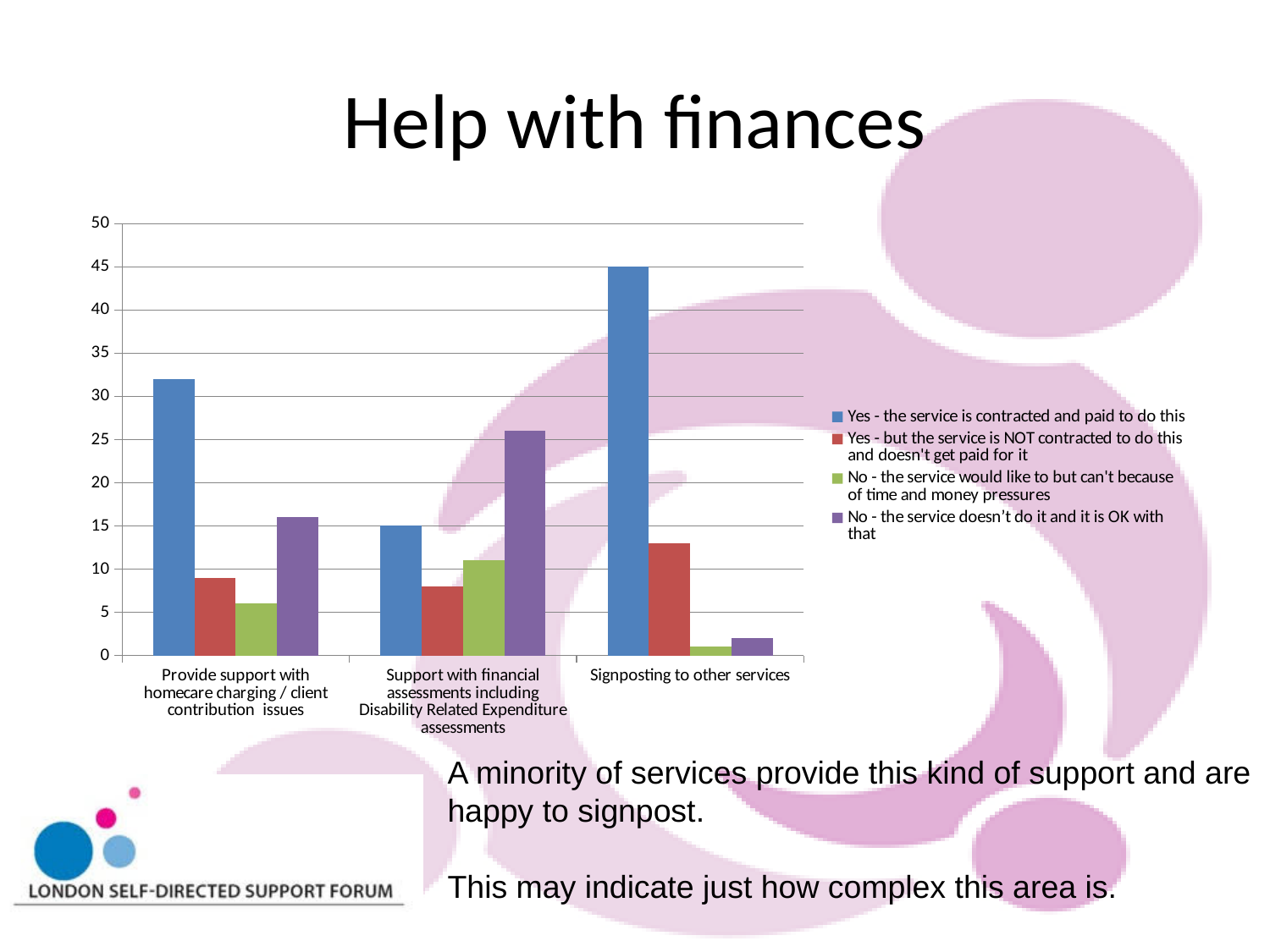
Is the value for 'No - the service doesn't do it and it is OK with that' for 'Support with financial assessments including Disability Related Expenditure assessments' greater or less than 25? greater What kind of chart is shown on the slide? bar chart What colour represents 'Yes - the service is contracted and paid to do this' in the chart? blue For 'Provide support with homecare charging / client contribution issues', which is larger: 'Yes - but the service is NOT contracted to do this and doesn't get paid for it' or 'No - the service doesn't do it and it is OK with that'? No - the service doesn't do it and it is OK with that Is the value for 'Yes - the service is contracted and paid to do this' for 'Provide support with homecare charging / client contribution issues' greater or less than 30? greater Which category has the lowest value for 'No - the service doesn't do it and it is OK with that'? Signposting to other services How many series does the legend list? 4 Which category has the highest value for 'Yes - the service is contracted and paid to do this'? Signposting to other services What is the value for 'Yes - the service is contracted and paid to do this' for 'Support with financial assessments including Disability Related Expenditure assessments'? 15 How many categories are shown on the x axis? 3 Is the value for 'No - the service would like to but can't because of time and money pressures' for 'Signposting to other services' greater or less than 5? less What is the value for 'Yes - the service is contracted and paid to do this' for 'Signposting to other services'? 45